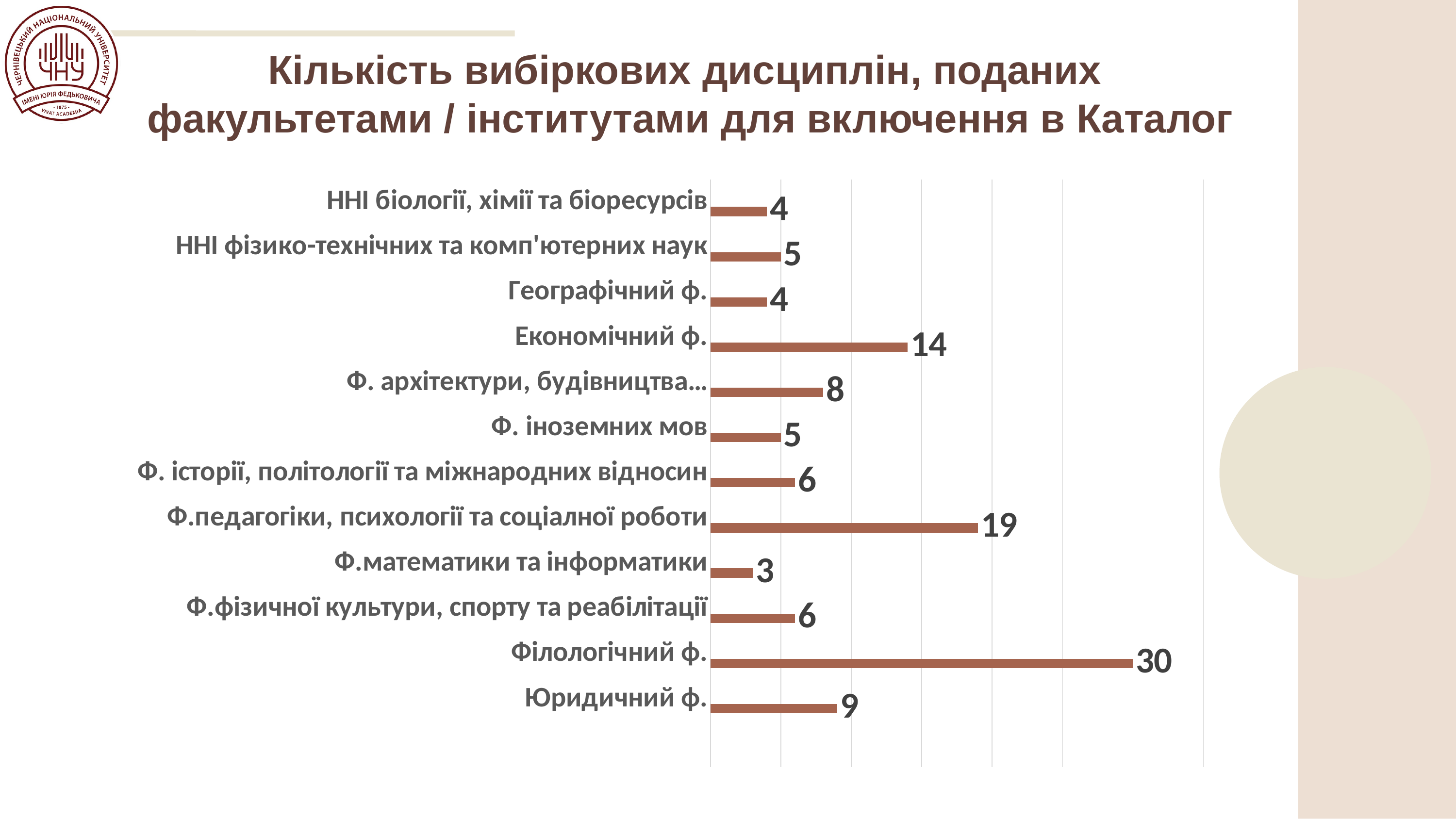
Which category has the highest value? Філологічний ф. What is the value for Філологічний ф.? 30 What is the value for Економічний ф.? 14 What is the difference between the values for Філологічний ф. and Ф.педагогіки, психології та соціалної роботи? 11 What is the value for Юридичний ф.? 9 What is the difference between the values for Юридичний ф. and Ф.математики та інформатики? 6 What is the title of the slide? Кількість вибіркових дисциплін, поданих факультетами / інститутами для включення в Каталог Which category has the lowest value? Ф.математики та інформатики What kind of chart is shown on the slide? bar chart Which is larger: the value for Економічний ф. or the value for Ф. архітектури, будівництва…? Економічний ф. What is the value for Ф.педагогіки, психології та соціалної роботи? 19 How many categories are shown in the chart? 12